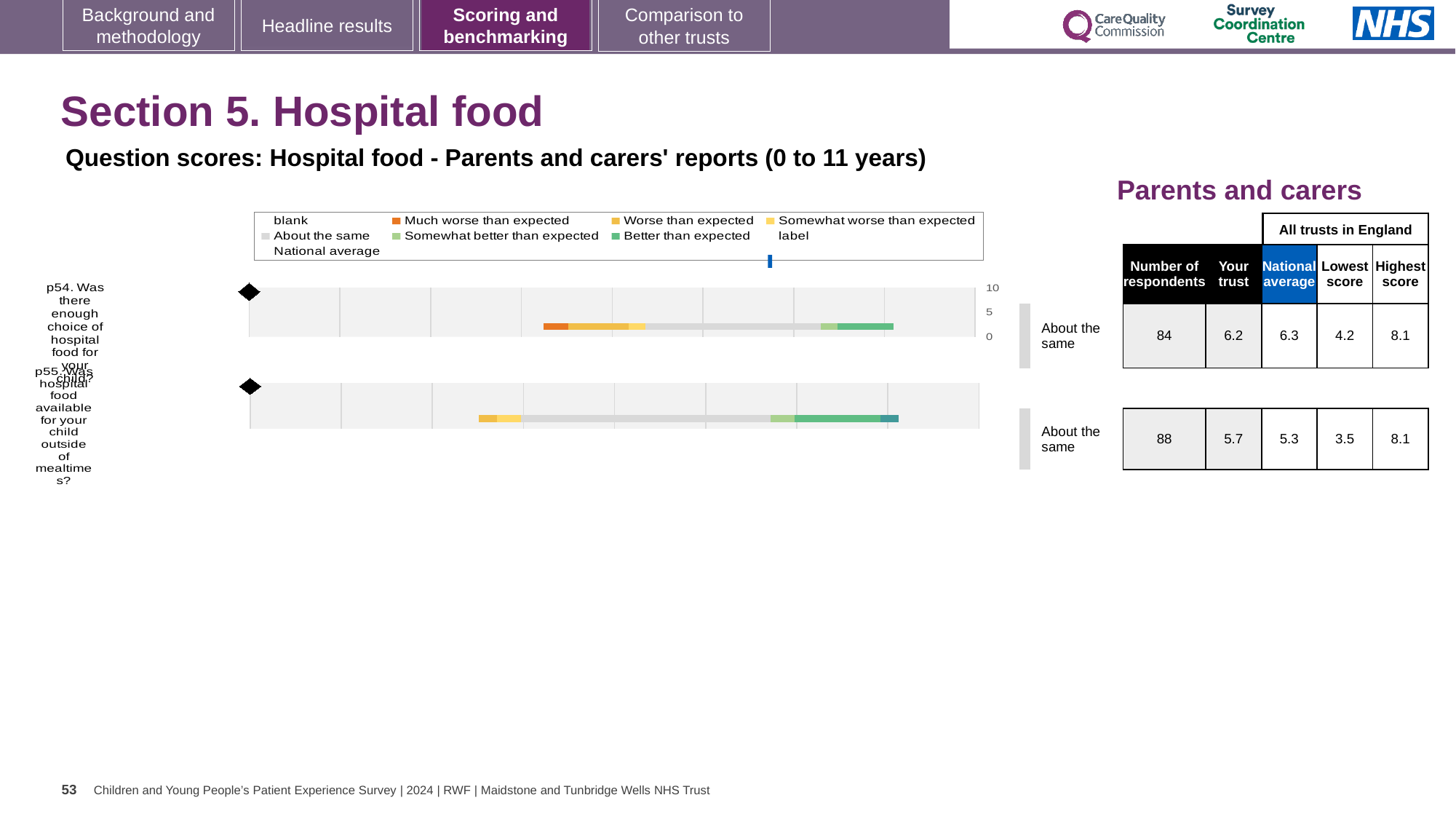
How many survey questions are plotted in the hospital food chart? 2 What is the 'Your trust' score for p54 (enough choice of hospital food for your child)? 6.2 What kind of chart is used to show the question scores for p54 and p55? Bar chart What is the lowest score across all trusts in England for p54? 4.2 Which legend entry is shown in orange in the chart legend? Much worse than expected Which is larger for p55: the trust's score or the national average? Your trust (5.7) Which question has the lower 'Your trust' score, p54 or p55? p55 What is the difference between the trust's score and the national average for p55? 0.4 How many respondents answered p55? 88 What is the maximum value shown on the chart's score axis? 10 What is the national average score for p55 (hospital food available outside of mealtimes)? 5.3 What benchmark category is the trust placed in for both p54 and p55? About the same